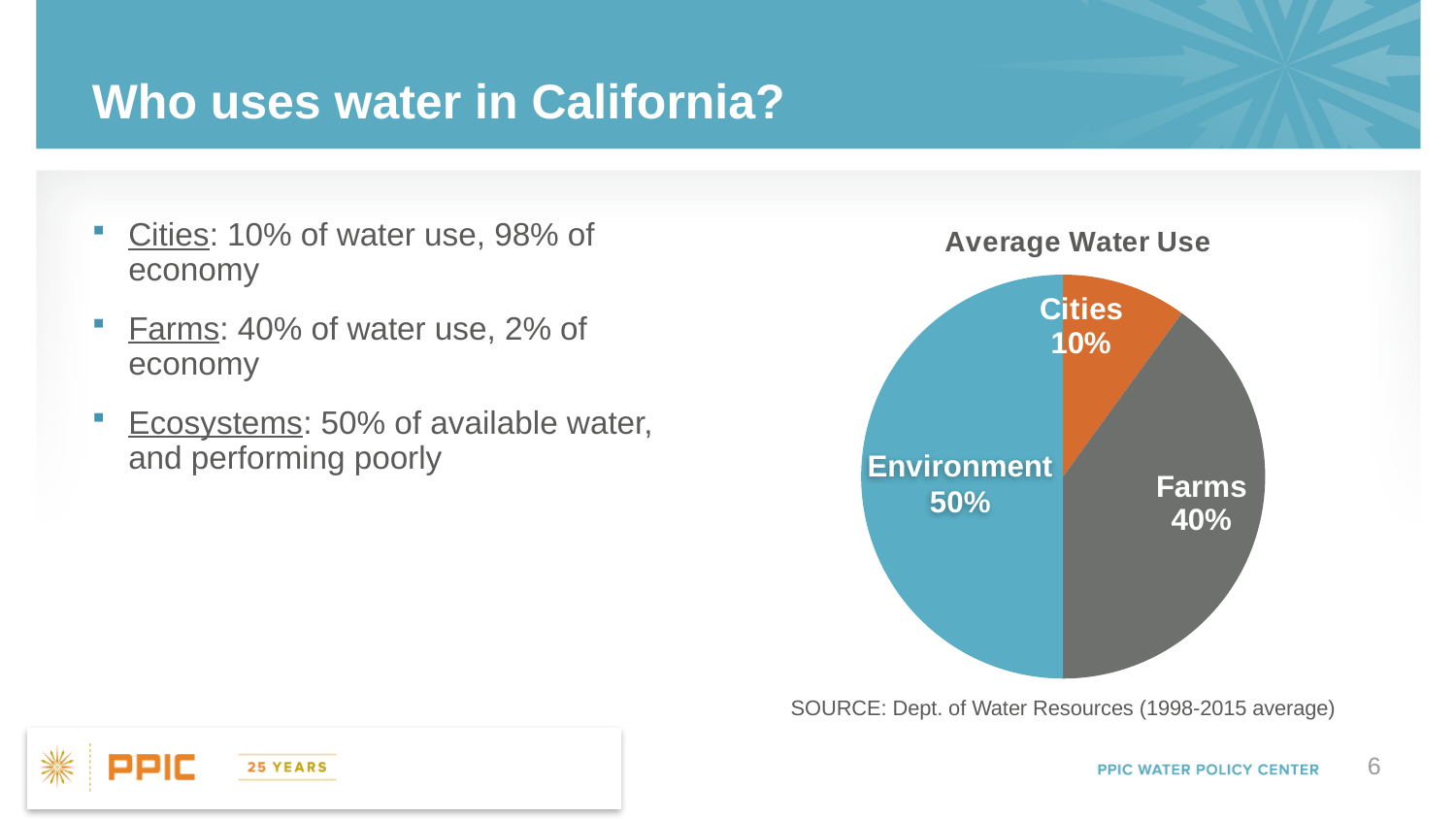
What is the title of the chart? Average Water Use What share of average water use goes to Cities? 10% Which category has the largest share of average water use? Environment What share of average water use goes to Environment? 50% What kind of chart is shown on the slide? pie chart What is the difference in percentage points between the Environment and Farms shares? 10 Which uses a larger share of water, Farms or Cities? Farms Which category has the smallest share of average water use? Cities How many slices does the pie chart have? 3 What is the difference in percentage points between the Farms and Cities shares? 30 What share of average water use goes to Farms? 40% What colour is the Cities slice of the pie chart? orange